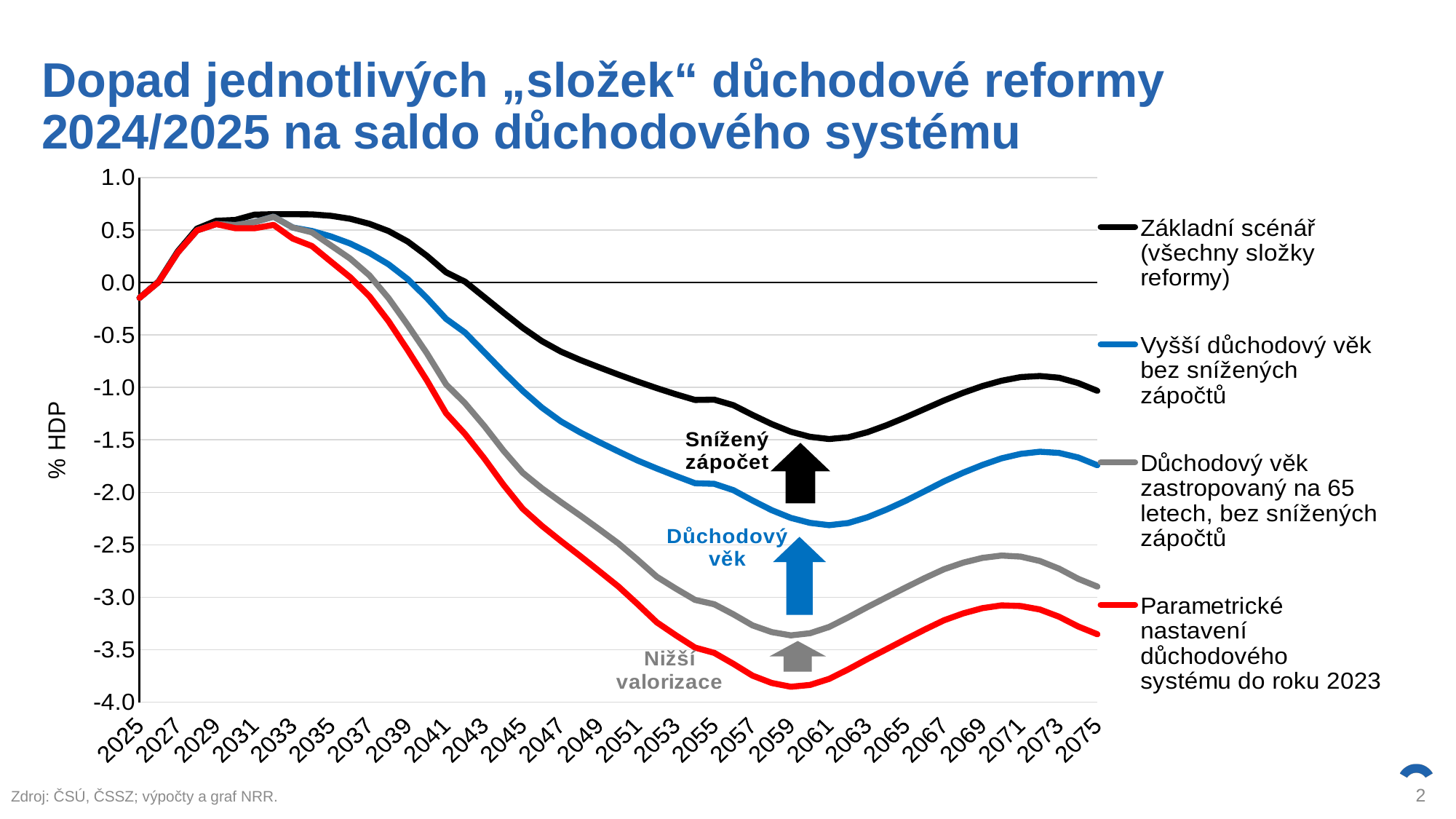
What kind of chart is shown on the slide? line chart Is the value for Důchodový věk zastropovaný na 65 letech, bez snížených zápočtů in 2059 greater or less than -3.0? less What is the label on the y axis? % HDP Is the value for Parametrické nastavení důchodového systému do roku 2023 in 2059 greater or less than -3.5? less How many year labels are shown on the x axis? 26 Is the value for Vyšší důchodový věk bez snížených zápočtů in 2061 greater or less than -2.0? less Which series has the lowest value in 2075? Parametrické nastavení důchodového systému do roku 2023 Does the Základní scénář line rise or fall between 2033 and 2061? fall How many series does the legend list? 4 In 2059, which series has the higher value: Základní scénář or Parametrické nastavení důchodového systému do roku 2023? Základní scénář